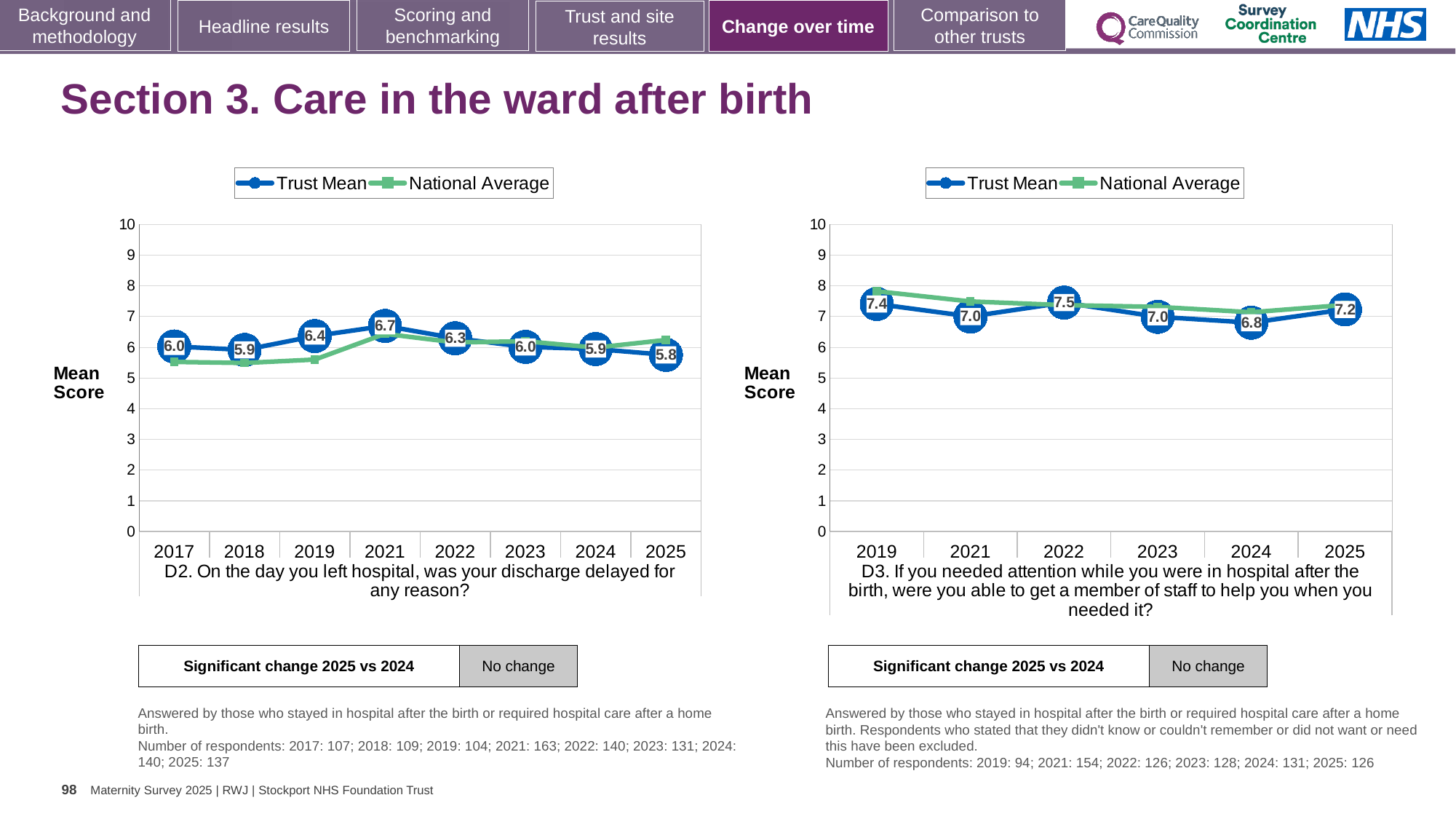
In the D3 chart (right), is the Trust Mean for 2019 greater or less than the Trust Mean for 2021? greater In the D3 chart (right), what is the Trust Mean for 2022? 7.5 In the D3 chart (right), which year has the lowest Trust Mean? 2024 In the D2 chart (left), what is the Trust Mean for 2025? 5.8 In the D3 chart (right), is the National Average for 2019 greater or less than 7? greater In the D2 chart (left), which year has the lowest Trust Mean? 2025 In the D2 chart (left), how many years are plotted on the x axis? 8 In the D2 chart (left), what is the difference between the Trust Mean for 2021 and 2025? 0.9 In the D2 chart (left), what is the Trust Mean for 2021? 6.7 How many series does the legend of the D3 chart (right) list? 2 In the D2 chart (left), which year has the highest Trust Mean? 2021 What kind of chart is the D2 chart (left)? Line chart